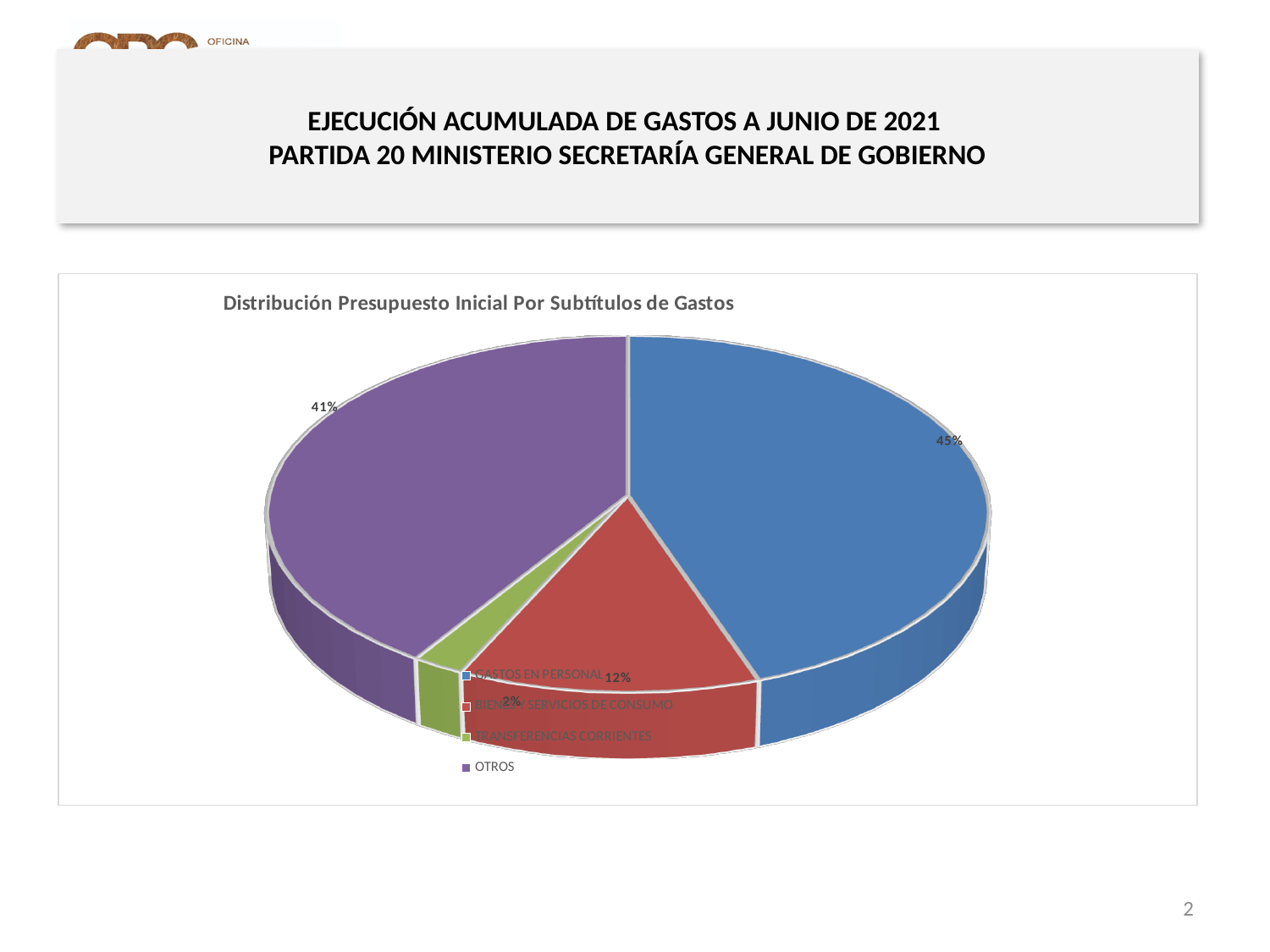
What colour is the slice for OTROS? Purple What kind of chart is shown on the slide? Pie chart Which category has the largest slice of the pie? GASTOS EN PERSONAL How many categories does the pie chart show? 4 What share of the pie does GASTOS EN PERSONAL represent? 45% What share of the pie does BIENES Y SERVICIOS DE CONSUMO represent? 12% Which category has the smallest slice of the pie? TRANSFERENCIAS CORRIENTES What is the title of the chart? Distribución Presupuesto Inicial Por Subtítulos de Gastos What is the difference in percentage points between GASTOS EN PERSONAL and OTROS? 4 percentage points What share of the pie does TRANSFERENCIAS CORRIENTES represent? 2% Which is larger, the slice for BIENES Y SERVICIOS DE CONSUMO or the slice for TRANSFERENCIAS CORRIENTES? BIENES Y SERVICIOS DE CONSUMO